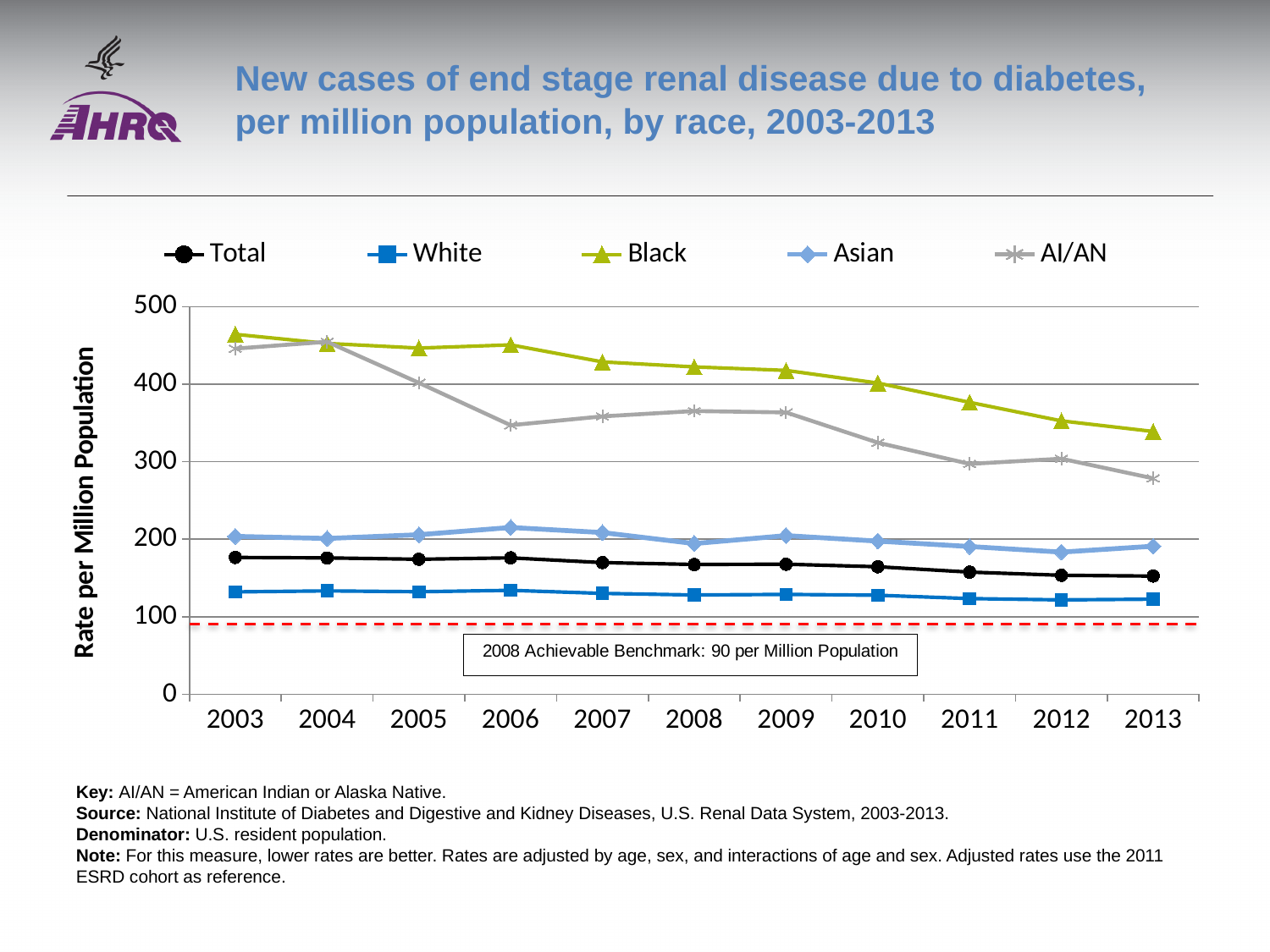
What is the 2008 achievable benchmark shown on the chart? 90 per Million Population Is the value for Black in 2003 greater or less than 400? greater Is the value for AI/AN in 2013 greater or less than 300? less Which race group has the highest rate in 2013? Black How many series does the legend list? 5 In 2010, which is larger, the rate for Asian or the rate for Total? Asian In 2013, which is larger, the rate for Black or the rate for AI/AN? Black Does the rate for Black rise or fall from 2003 to 2013? fall Is the value for Total in 2003 greater or less than 200? less Which race group has the lowest rate in 2013? White What kind of chart is shown on the slide? line chart How many years are shown along the x axis? 11